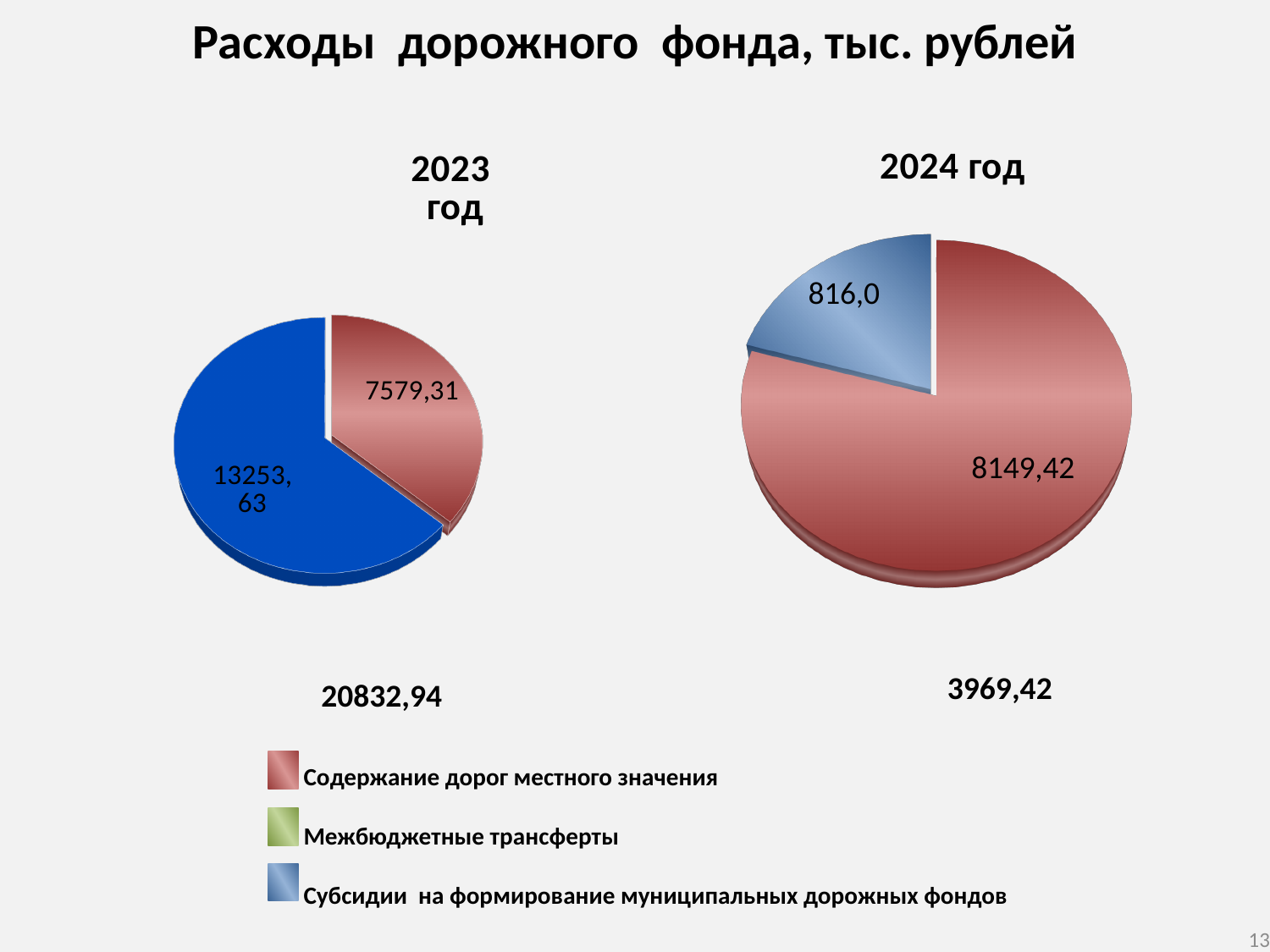
In the 2024 год chart, which category has the smallest slice? Субсидии на формирование муниципальных дорожных фондов In the 2024 год chart, which is larger: Содержание дорог местного значения or Субсидии на формирование муниципальных дорожных фондов? Содержание дорог местного значения In the 2024 год chart, what is the value for Субсидии на формирование муниципальных дорожных фондов? 816,0 In the 2023 год chart, what is the value for Субсидии на формирование муниципальных дорожных фондов? 13253,63 How many entries does the legend list? 3 In the 2023 год chart, what is the difference between Субсидии на формирование муниципальных дорожных фондов and Содержание дорог местного значения? 5674,32 In the 2023 год chart, which category has the largest slice? Субсидии на формирование муниципальных дорожных фондов In the 2023 год chart, what is the value for Содержание дорог местного значения? 7579,31 What kind of chart is used for the 2024 год data? Pie chart What total is shown below the 2023 год chart? 20832,94 In the 2024 год chart, what is the value for Содержание дорог местного значения? 8149,42 In the 2024 год chart, what is the difference between Содержание дорог местного значения and Субсидии на формирование муниципальных дорожных фондов? 7333,42